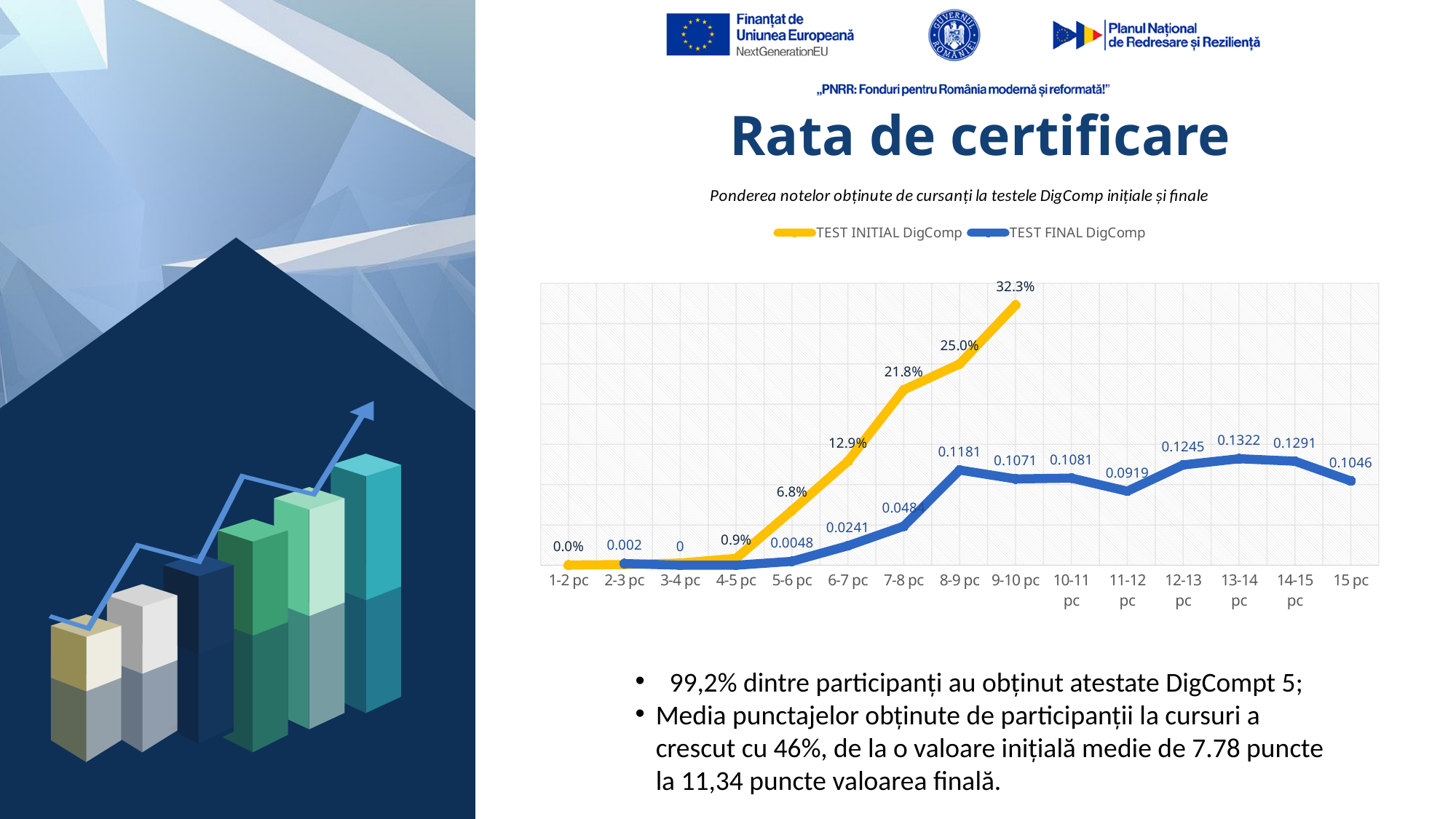
What kind of chart is shown on the slide? line chart How many series does the legend list? 2 Which colour represents the TEST INITIAL DigComp series? yellow What is the difference between the TEST INITIAL DigComp values for 9-10 pc and 8-9 pc? 7.3% Which category has the highest labelled value for TEST FINAL DigComp? 13-14 pc Which category has the highest value for TEST INITIAL DigComp? 9-10 pc How many categories are shown on the x axis? 15 Which is larger for TEST FINAL DigComp: the value for 8-9 pc or the value for 9-10 pc? 8-9 pc What is the value of TEST FINAL DigComp for 13-14 pc? 0.1322 What is the value of TEST INITIAL DigComp for 9-10 pc? 32.3% What is the value of TEST FINAL DigComp for 11-12 pc? 0.0919 What is the value of TEST INITIAL DigComp for 6-7 pc? 12.9%